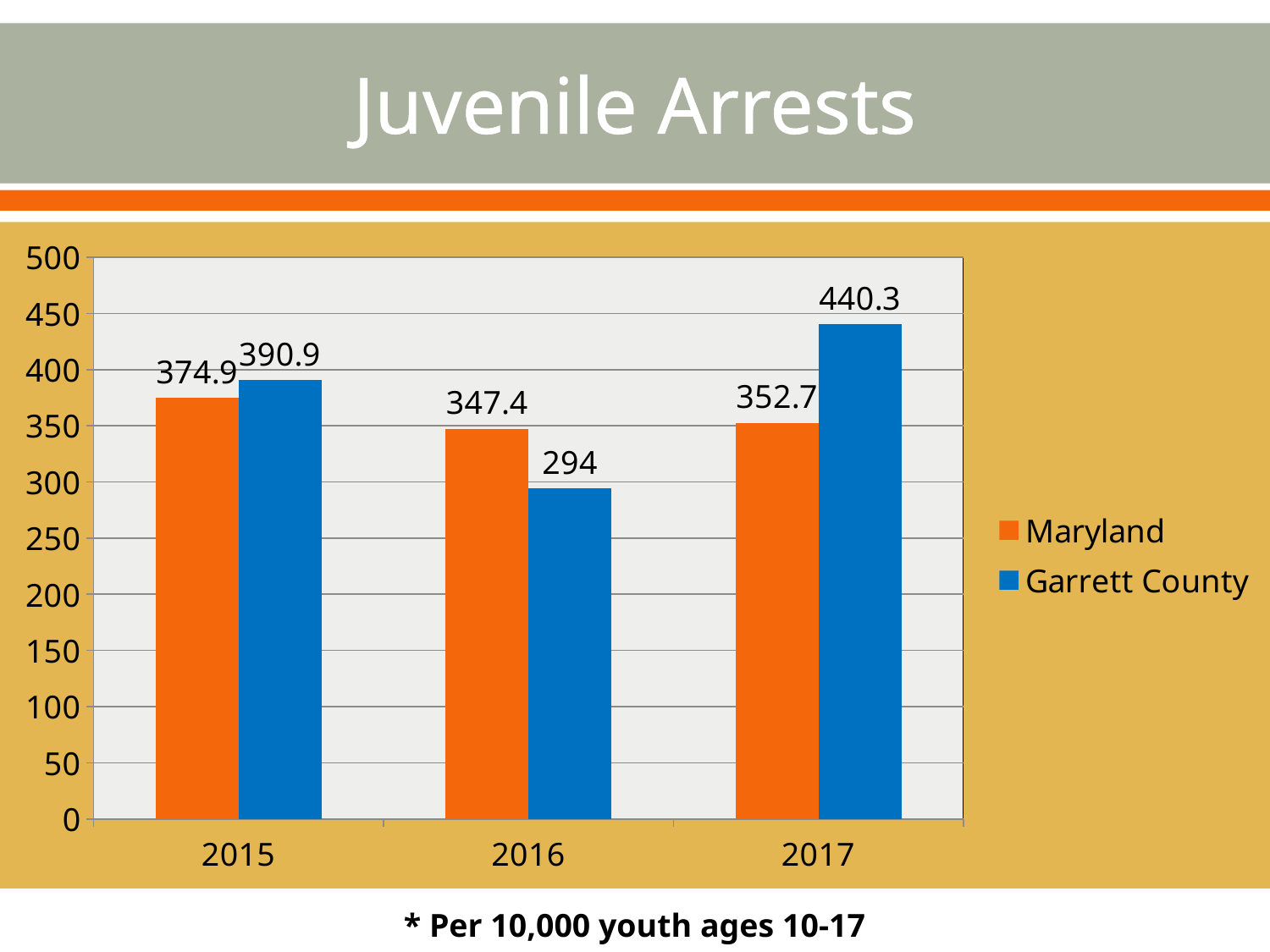
How many years are shown on the x axis? 3 In which year is the Garrett County value highest? 2017 Is the Garrett County value for 2015 greater or less than 350? greater How many series does the legend list? 2 In which year is the Maryland value lowest? 2016 What is the Garrett County value for 2016? 294 What kind of chart is shown? bar chart Which is larger in 2016, Maryland or Garrett County? Maryland What is the Maryland value for 2015? 374.9 What is the Garrett County value for 2017? 440.3 What is the title of the chart? Juvenile Arrests What is the difference between the Garrett County and Maryland values in 2017? 87.6